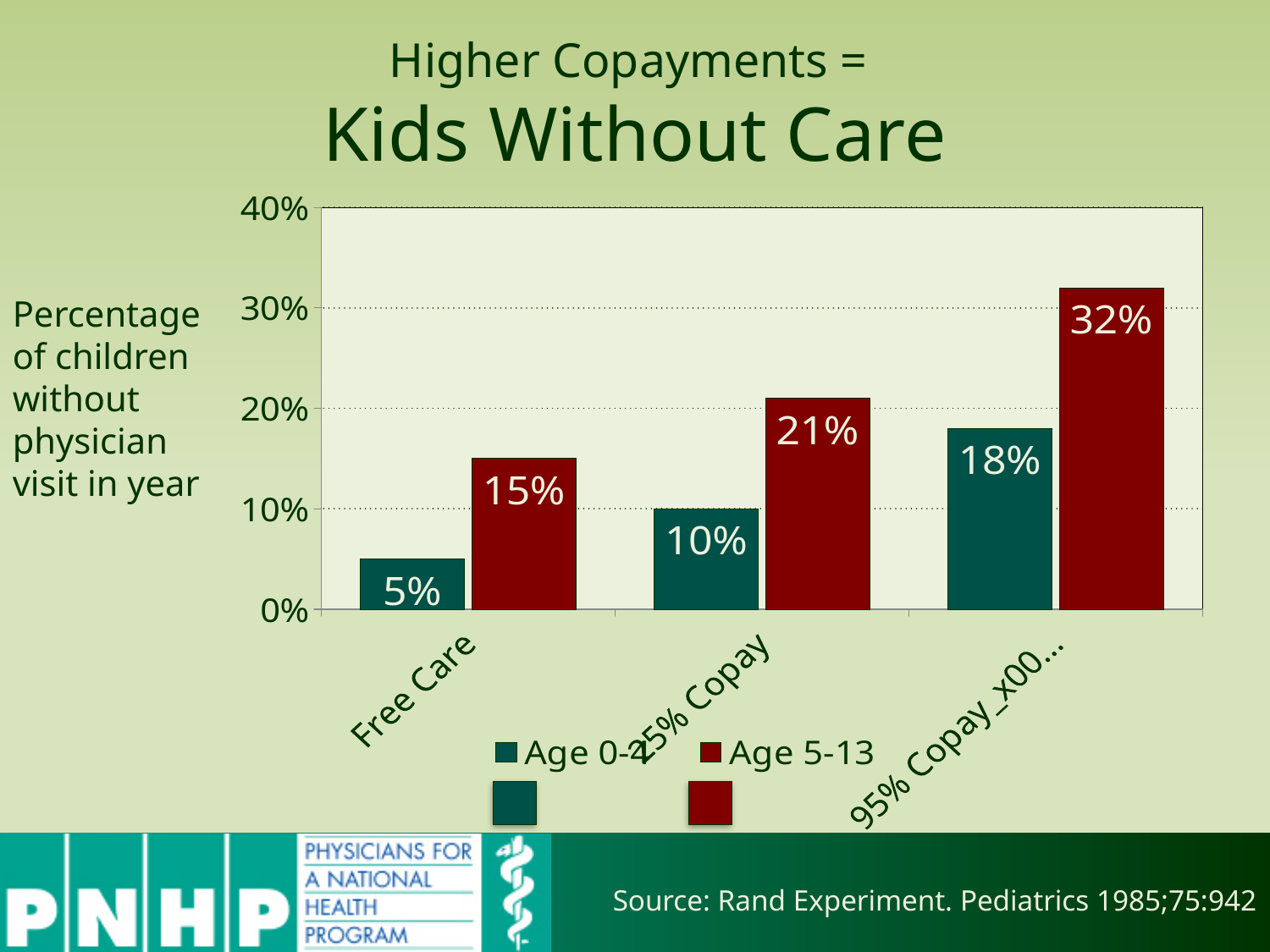
How many categories are shown on the x axis? 3 Which category has the lowest value for the teal (younger age group) series? Free Care What kind of chart is shown on the slide? bar chart Do the Age 5-13 values rise or fall from Free Care to 95% Copay? rise What is the difference between the Age 5-13 value and the teal bar value under 25% Copay? 11% Which category has the highest Age 5-13 value? 95% Copay How many series does the legend list? 2 What is the value for Age 5-13 under Free Care? 15% Which is larger: the Age 5-13 value under Free Care or the teal bar value under 95% Copay? the teal bar under 95% Copay (18%) What is the value of the teal bar under Free Care? 5% What is the value for Age 5-13 in the third category (95% Copay)? 32% What is the value of the teal (younger age group) bar under 25% Copay? 10%